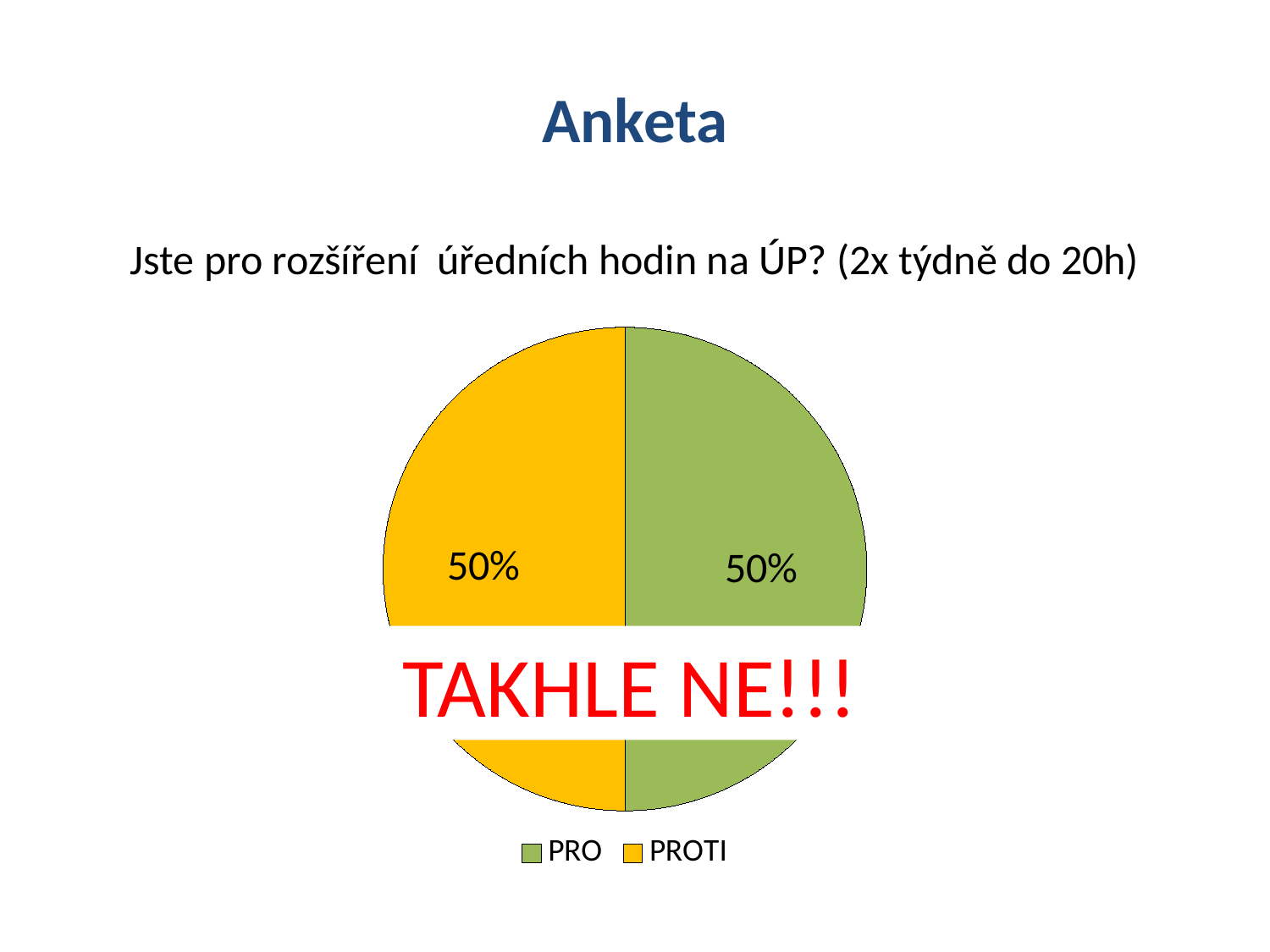
What share of the pie does the PROTI slice represent? 50% What is the difference between the PRO and PROTI shares? 0% Which colour represents PRO in the pie chart? green Which colour represents PROTI in the pie chart? orange What share of the pie does the PRO slice represent? 50% What is the combined share of the PRO and PROTI slices? 100% How many entries does the legend list? 2 How many slices does the pie chart have? 2 What kind of chart is shown on the slide? pie chart